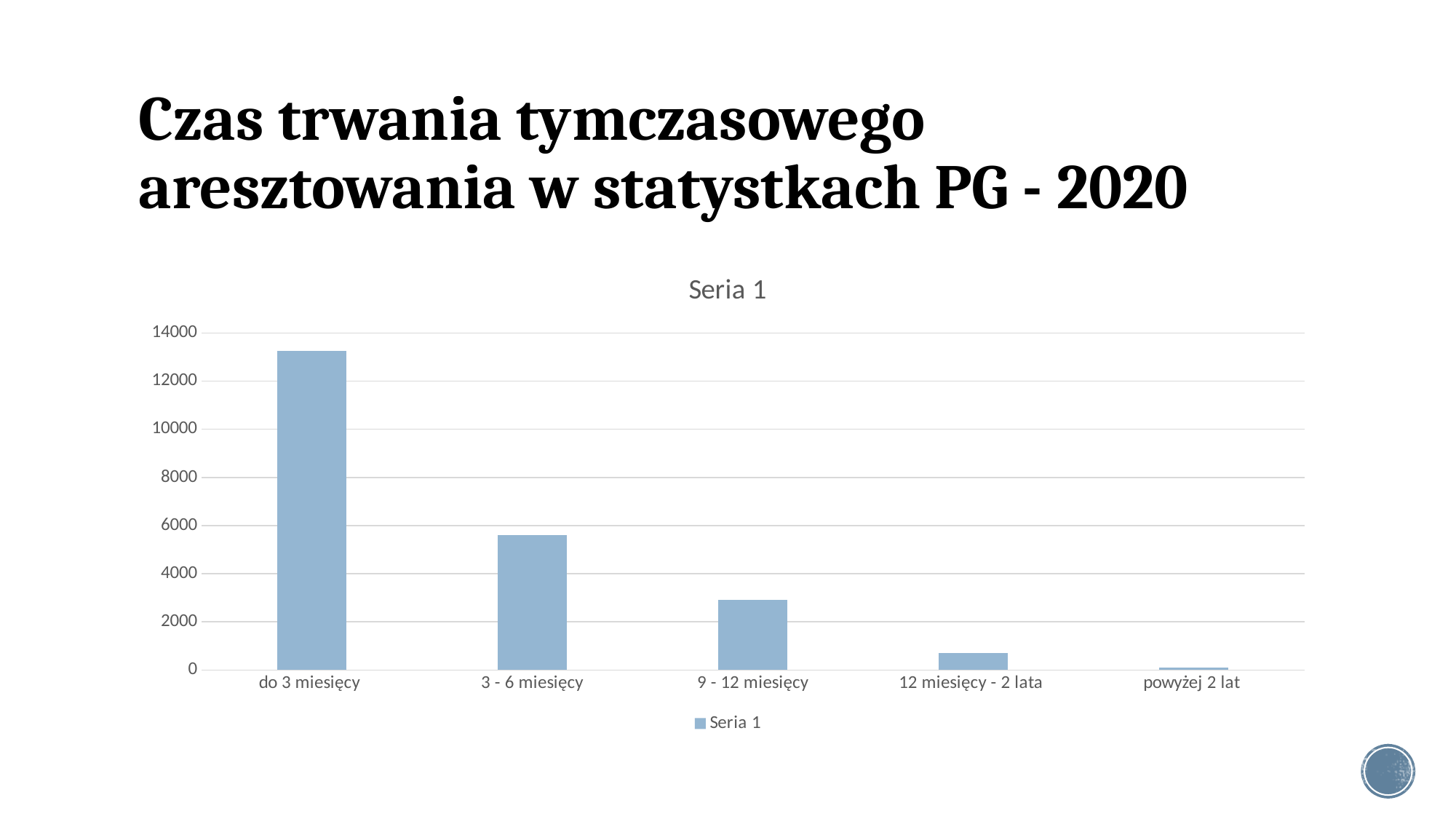
Is the value for 12 miesięcy - 2 lata greater or less than 2000? less How many categories are shown on the x axis of the chart? 5 Which is larger, the value for 3 - 6 miesięcy or the value for 9 - 12 miesięcy? 3 - 6 miesięcy Is the value for do 3 miesięcy greater or less than 12000? greater How many series does the chart legend list? 1 Which category has the lowest value in the chart? powyżej 2 lat What kind of chart is shown on the slide? bar chart What is the name of the series shown in the chart legend? Seria 1 Is the value for 9 - 12 miesięcy greater or less than 2000? greater Which category has the highest value in the chart? do 3 miesięcy Do the values rise or fall from left to right along the x axis? fall